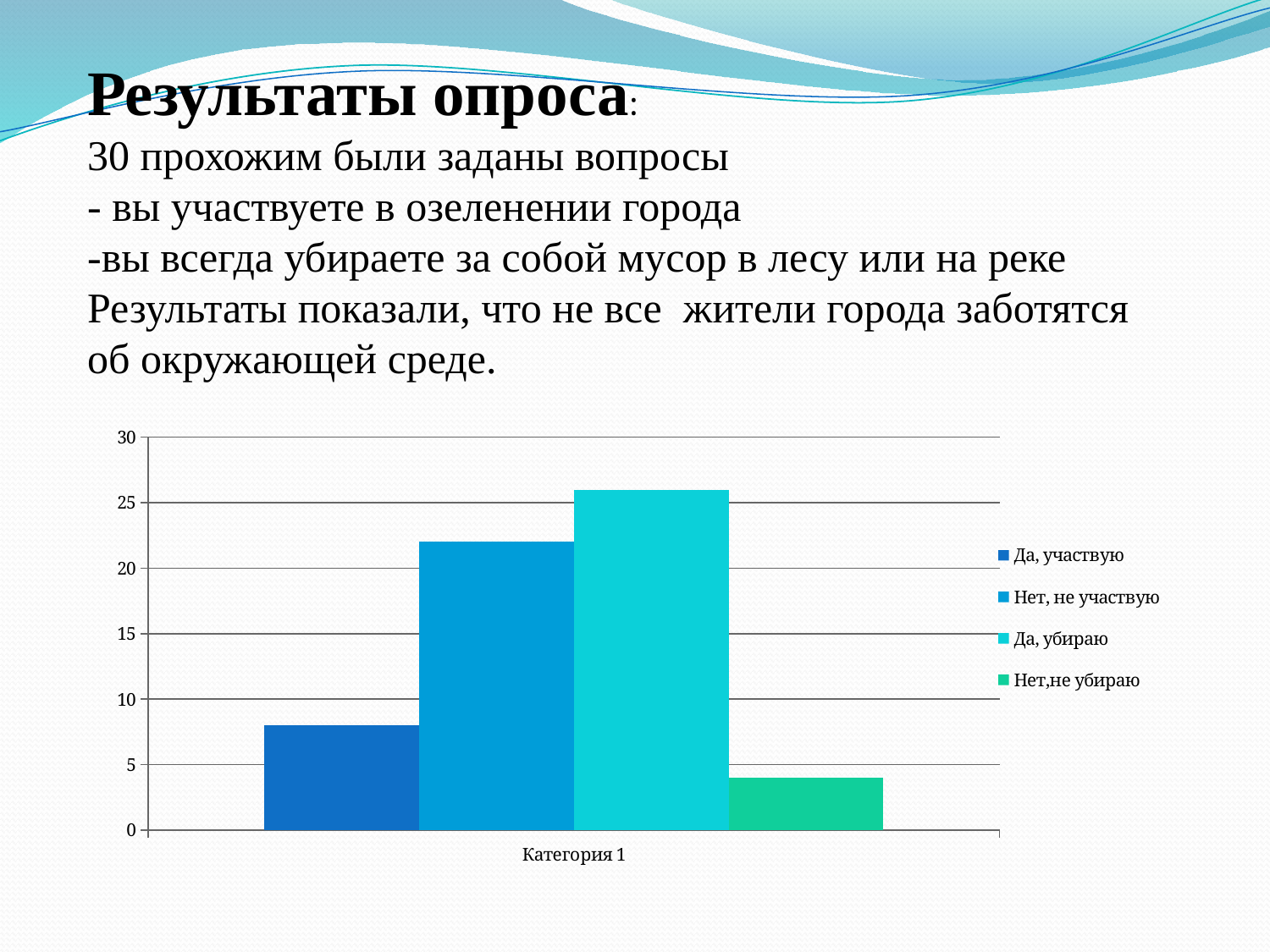
Is the value for "Нет,не убираю" greater or less than 5? less What is the highest value shown on the y axis? 30 How many categories are shown on the x axis? 1 What is the label of the category on the x axis? Категория 1 Is the value for "Да, убираю" greater or less than 25? greater What kind of chart is shown on the slide? bar chart How many series does the legend list? 4 Is the value for "Нет, не участвую" greater or less than 20? greater Which is larger, the value for "Да, участвую" or the value for "Нет, не участвую"? Нет, не участвую Which series has the highest bar? Да, убираю Which series has the lowest bar? Нет,не убираю